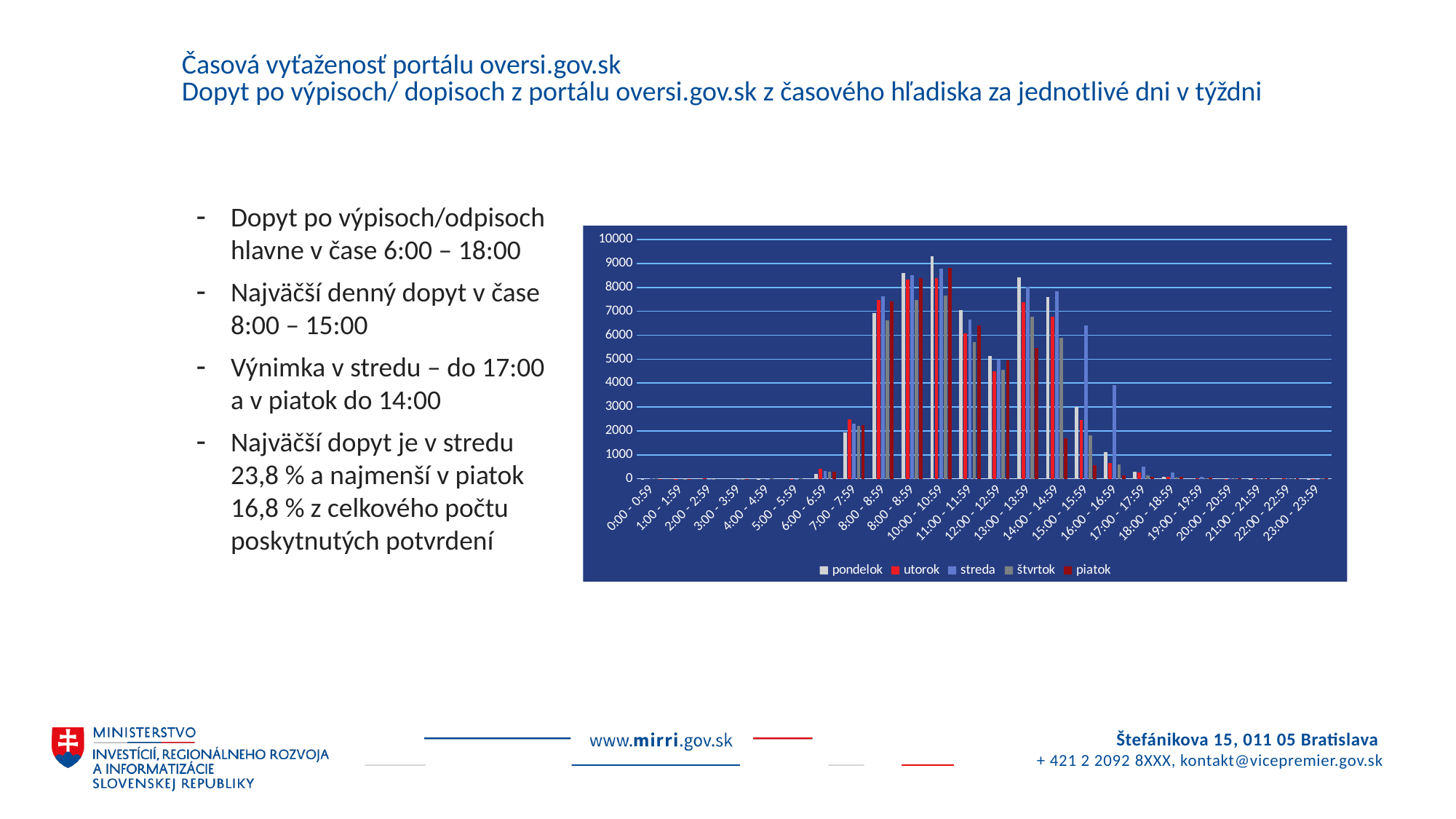
Which series has the highest value in the 10:00 - 10:59 category? pondelok Is the value for utorok in the 7:00 - 7:59 category greater or less than 2000? greater How many hourly time categories are shown on the x axis of the chart? 24 Which time category contains the tallest bar in the chart? 10:00 - 10:59 What kind of chart is shown on the slide? bar chart Is the value for streda in the 16:00 - 16:59 category greater or less than 3000? greater Is the value for pondelok in the 13:00 - 13:59 category greater or less than 8000? greater Do the pondelok values rise or fall from the 6:00 - 6:59 category to the 10:00 - 10:59 category? rise In the 16:00 - 16:59 category, which is larger: the value for streda or the value for piatok? streda Which series is shown in red in the chart legend? utorok How many series does the chart legend list? 5